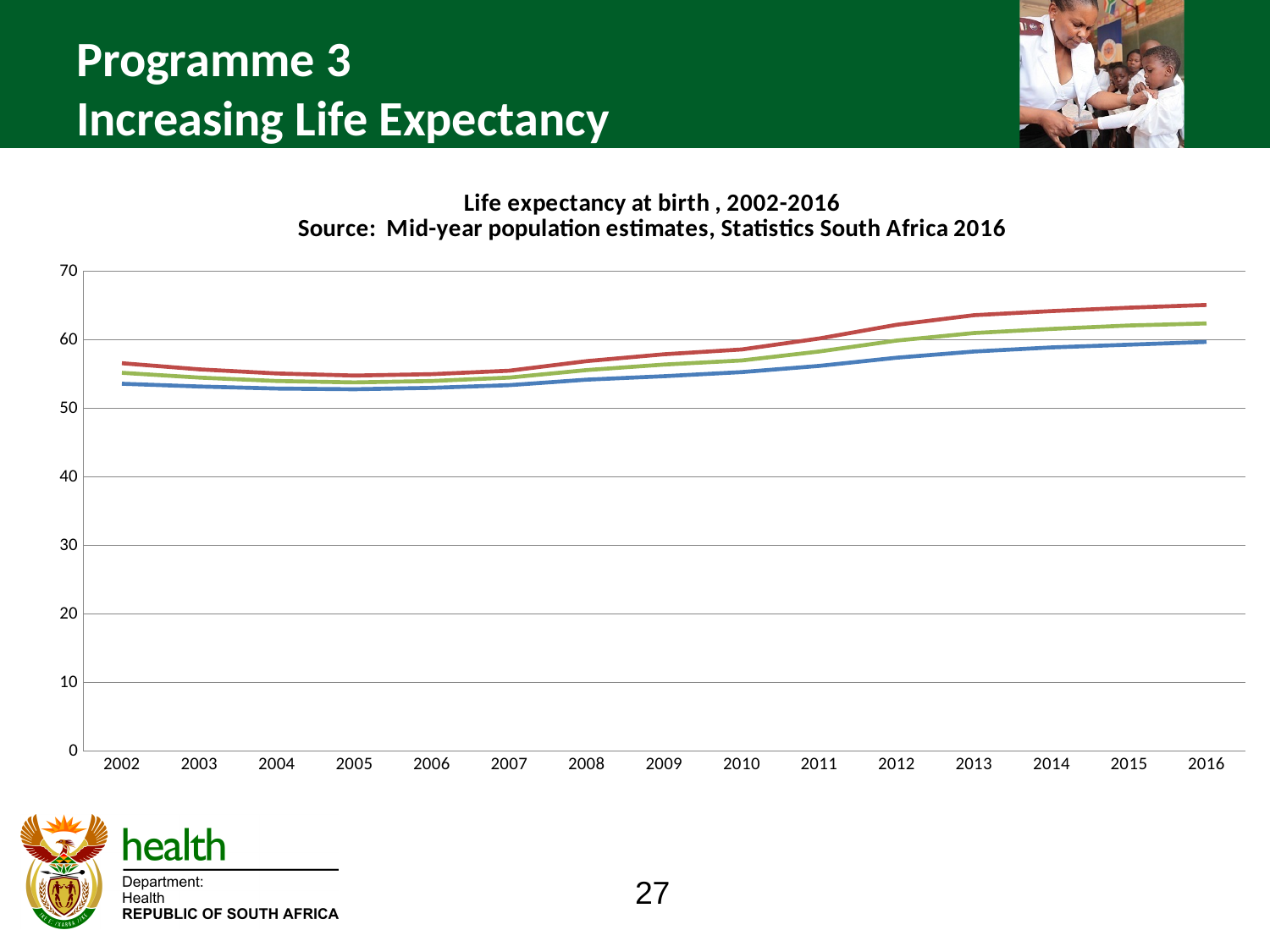
How many years are shown on the x axis of the chart? 15 How many lines are plotted on the chart? 3 What is the title of the chart? Life expectancy at birth , 2002-2016 What kind of chart is shown on the slide? line chart Is the value of the blue line in 2002 greater or less than 60? less Is the value of the red line in 2016 greater or less than 60? greater Is the value of the blue line in 2005 greater or less than 50? greater Overall, do the lines rise or fall from 2002 to 2016? rise What is the highest value shown on the y axis of the chart? 70 Between 2002 and 2005, do the lines rise or fall? fall In 2016, which line is higher, the red line or the blue line? the red line